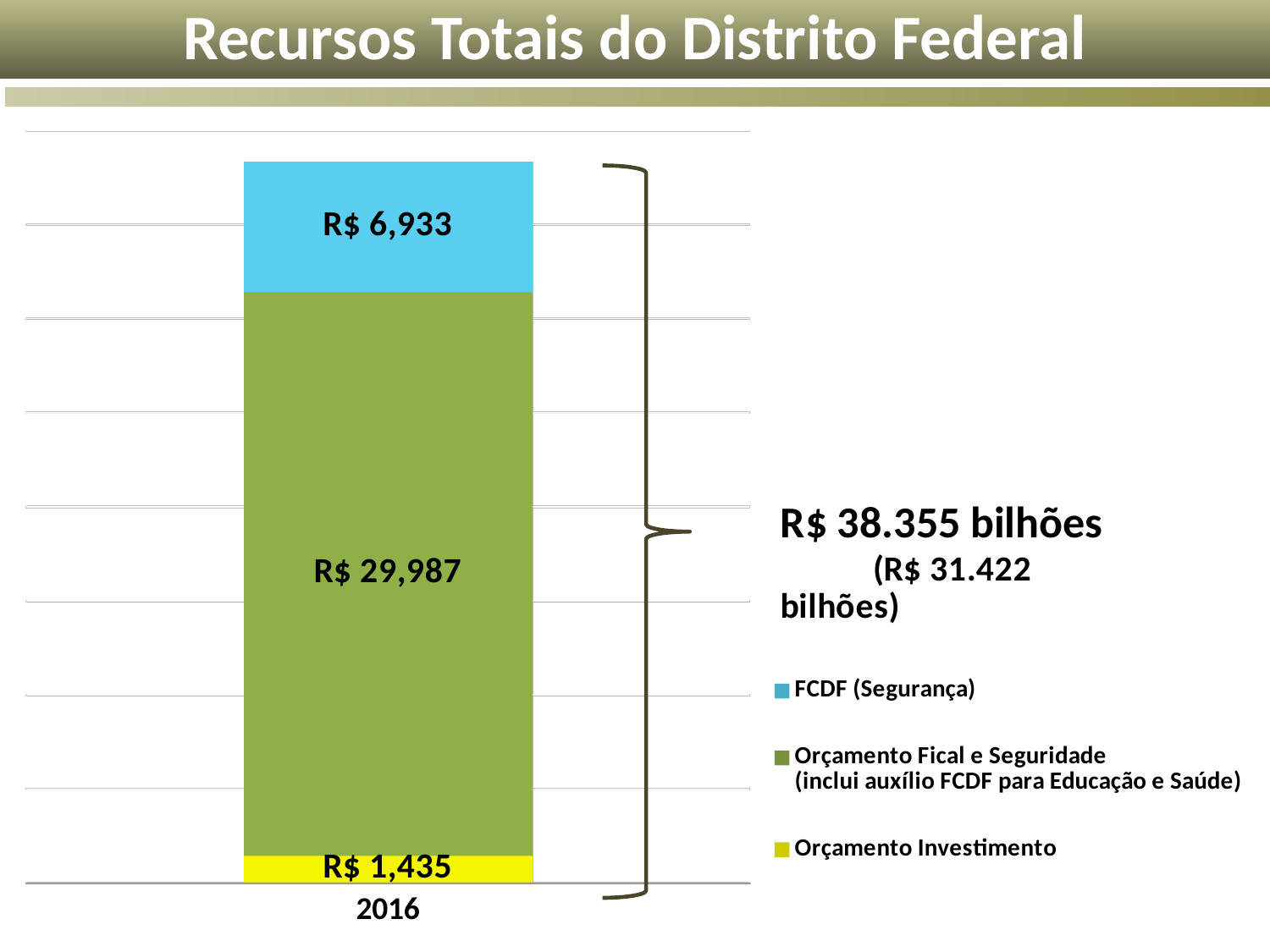
What is the value of the FCDF (Segurança) segment for 2016? R$ 6,933 What is the difference between the Orçamento Fical e Seguridade segment and the FCDF (Segurança) segment? R$ 23,054 What is the total of the stacked bar for 2016? R$ 38,355 Which series has the smallest segment in the 2016 bar? Orçamento Investimento Which series has the largest segment in the 2016 bar? Orçamento Fical e Seguridade What is the difference between the FCDF (Segurança) segment and the Orçamento Investimento segment? R$ 5,498 Which is larger, the FCDF (Segurança) segment or the Orçamento Investimento segment? FCDF (Segurança) How many series does the legend list? 3 What is the value of the Orçamento Fical e Seguridade segment for 2016? R$ 29,987 What type of chart is shown on the slide? stacked bar chart What is the value of the Orçamento Investimento segment for 2016? R$ 1,435 How many categories are shown on the x axis? 1